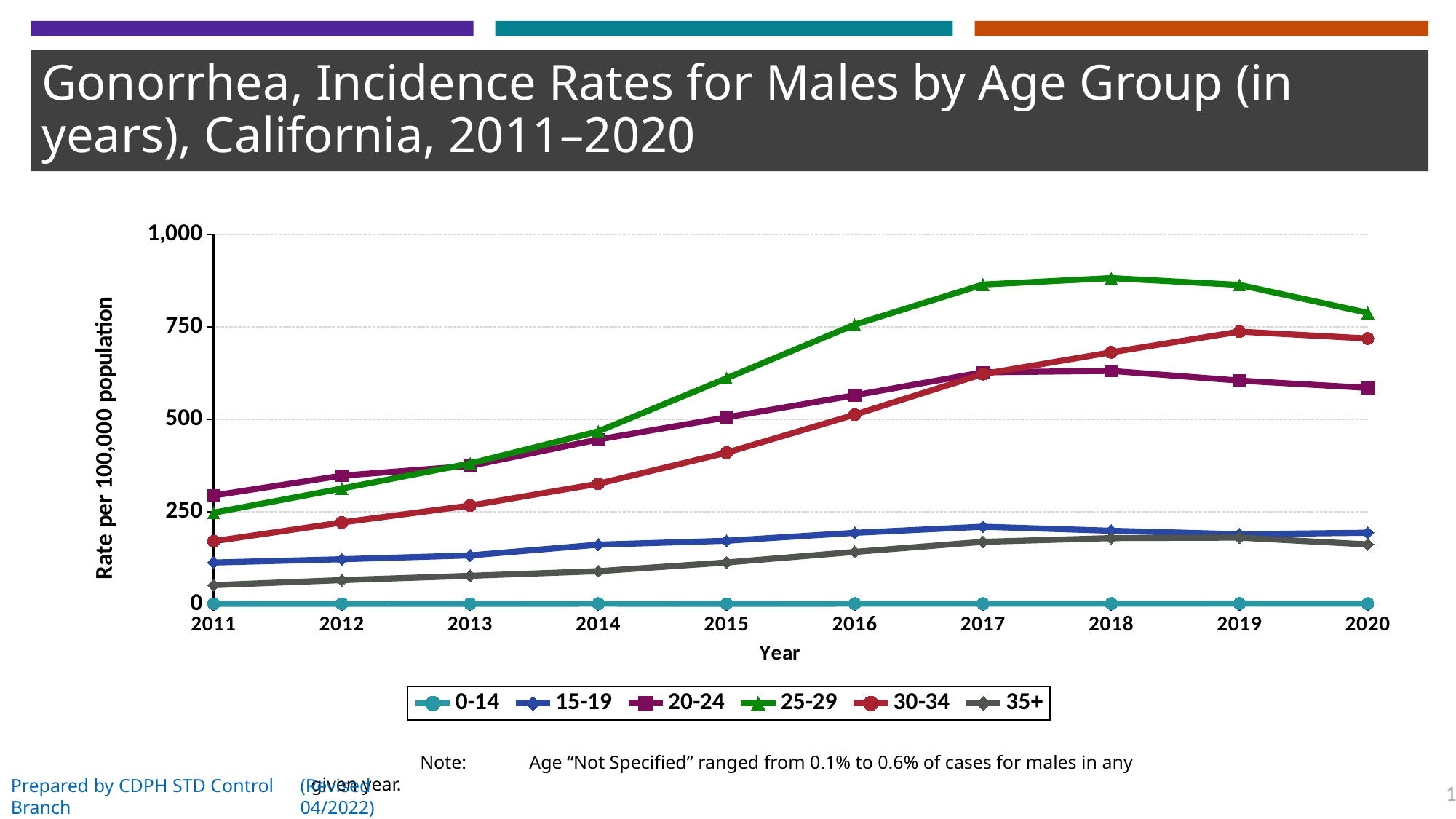
What kind of chart is shown on the slide? line chart Does the rate for the 25-29 age group rise or fall from 2011 to 2017? rise Is the value for the 35+ age group in 2011 greater or less than 250? less Is the value for the 15-19 age group in 2017 greater or less than 250? less In 2020, which age group has the higher rate: 30-34 or 20-24? 30-34 What is the label on the y axis? Rate per 100,000 population Which age group has the lowest incidence rate across all years? 0-14 Which age group has the highest incidence rate in 2018? 25-29 Is the value for the 20-24 age group in 2016 greater or less than 500? greater How many years are plotted along the x axis? 10 How many age-group series does the legend list? 6